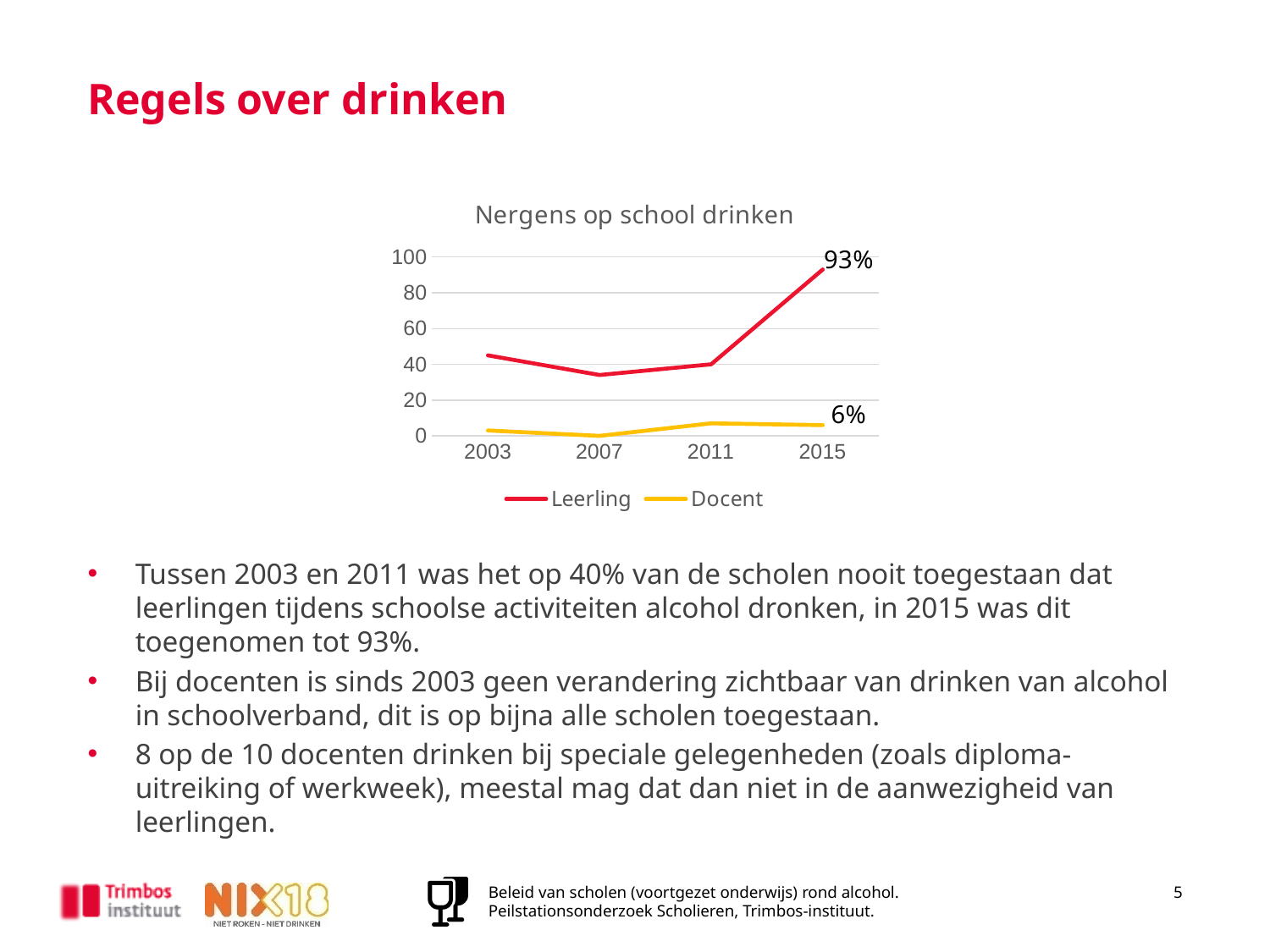
Does the Leerling series rise or fall between 2011 and 2015? rise What is the value for Docent in 2015? 6% How many series does the legend list? 2 In which year is the Leerling series at its highest? 2015 What is the difference between the Leerling and Docent values in 2015? 87 percentage points How many years are shown on the x axis? 4 Is the value for Leerling in 2007 greater or less than 40? less Is the value for Leerling in 2003 greater or less than 40? greater Is the value for Docent in 2011 greater or less than 20? less What is the value for Leerling in 2015? 93% In 2015, which series has the larger value, Leerling or Docent? Leerling What kind of chart is shown on the slide? line chart